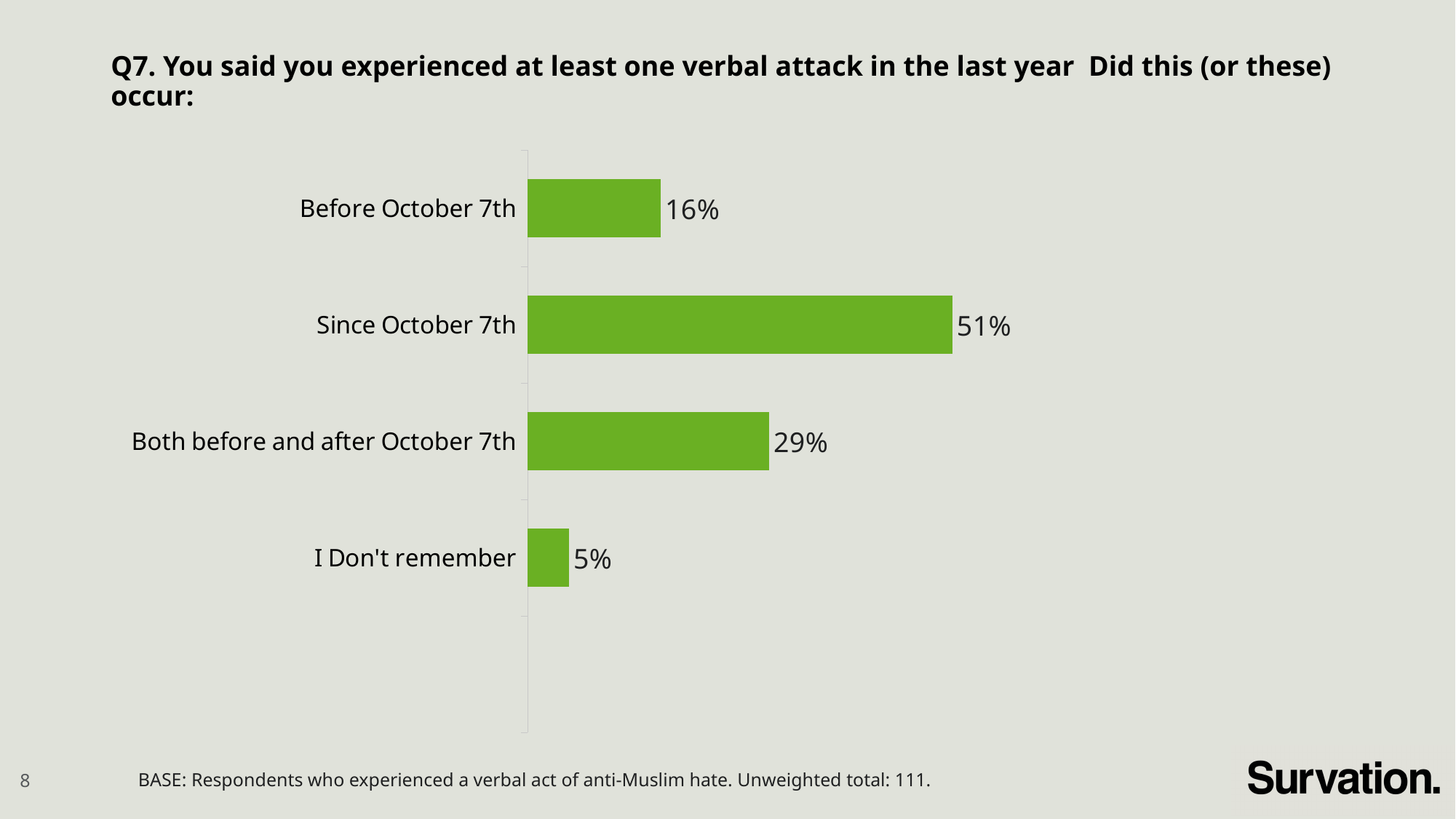
Which is larger: the value for 'Before October 7th' or for 'Both before and after October 7th'? Both before and after October 7th Which response category has the lowest percentage? I Don't remember Which response category has the highest percentage? Since October 7th What is the difference in percentage points between 'Both before and after October 7th' and 'I Don't remember'? 24 What percentage of respondents said the verbal attack occurred since October 7th? 51% How many response categories are shown in the chart? 4 What is the unweighted total of respondents stated in the base note? 111 What type of chart is shown on the slide? Bar chart What percentage of respondents said the verbal attack occurred before October 7th? 16% What is the difference in percentage points between 'Since October 7th' and 'Before October 7th'? 35 What percentage of respondents said the attacks occurred both before and after October 7th? 29% What percentage of respondents answered 'I Don't remember'? 5%